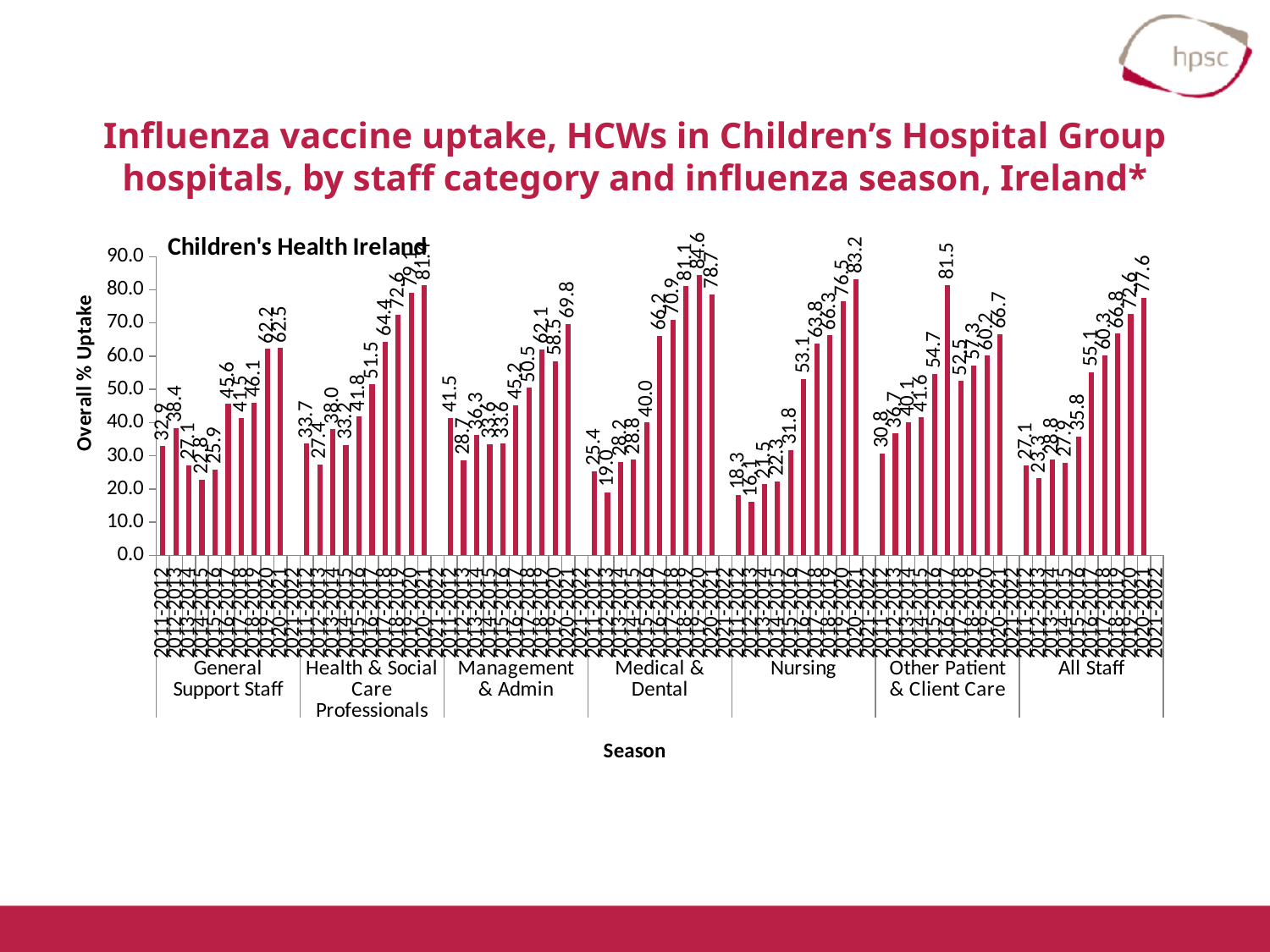
What is the highest value shown in the All Staff group? 77.6 What is the title of the vertical axis? Overall % Uptake Which staff category contains the lowest bar on the chart? Nursing What kind of chart is shown on the slide? Bar chart Do the All Staff values generally rise or fall across the seasons from left to right? Rise What is the highest value shown in the Other Patient & Client Care group? 81.5 What is the highest value shown in the Nursing group? 83.2 What is the lowest value shown anywhere on the chart? 16.1 What is the difference between the highest value in the Medical & Dental group (84.6) and the lowest value in the Nursing group (16.1)? 68.5 How many staff categories are shown along the x axis of the chart? 7 Which is larger: the highest value in the Management & Admin group or the highest value in the General Support Staff group? Management & Admin